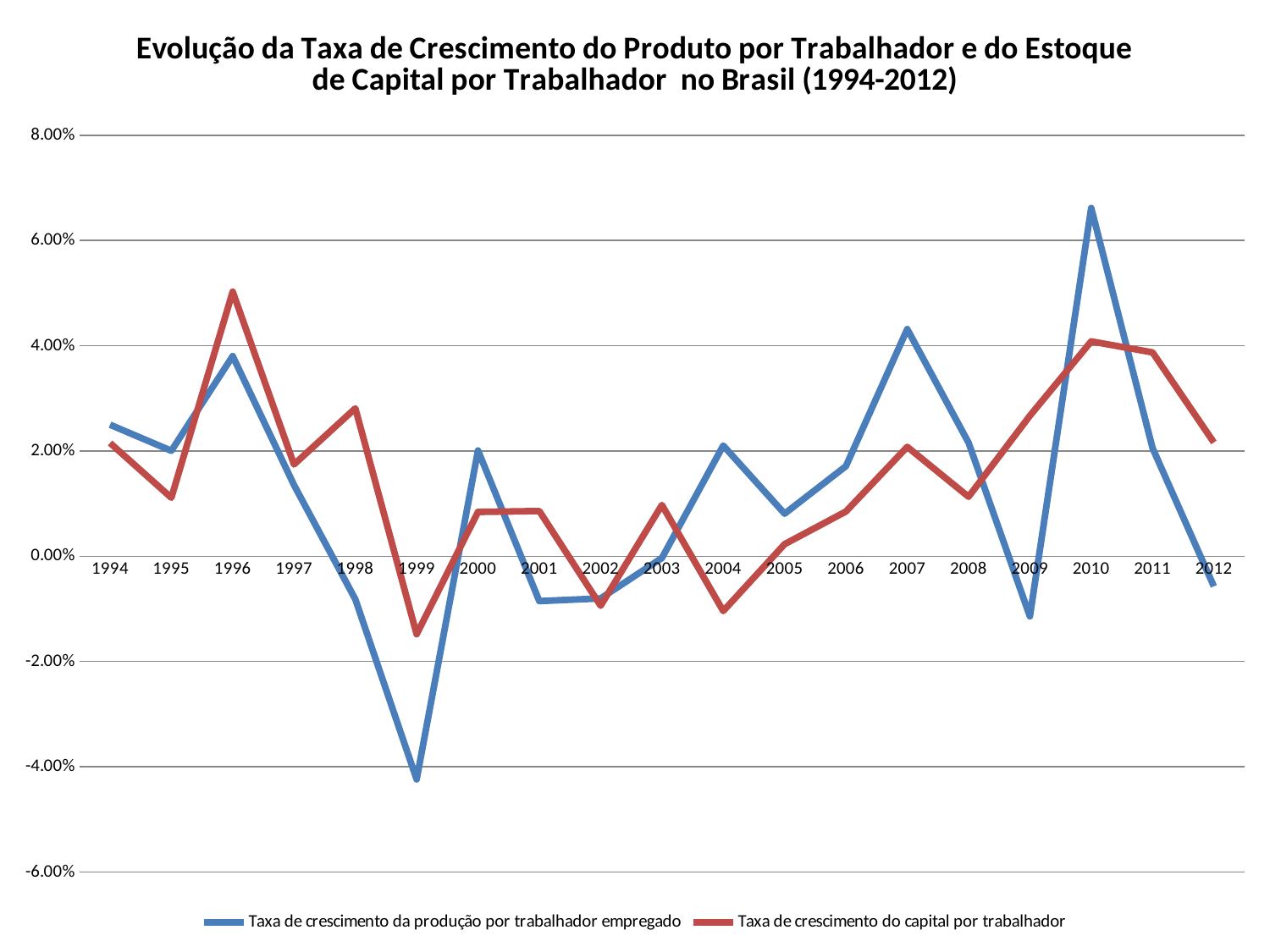
In which year does the 'Taxa de crescimento do capital por trabalhador' series reach its lowest value? 1999 How many series does the legend list? 2 In which year does the 'Taxa de crescimento da produção por trabalhador empregado' series reach its highest value? 2010 Is the value for 'Taxa de crescimento da produção por trabalhador empregado' in 1999 greater or less than -4.00%? less How many years are plotted along the x axis? 19 In which year does the 'Taxa de crescimento da produção por trabalhador empregado' series reach its lowest value? 1999 Is the value for 'Taxa de crescimento do capital por trabalhador' in 1996 greater or less than 4.00%? greater What kind of chart is shown on the slide? line chart Is the value for 'Taxa de crescimento da produção por trabalhador empregado' in 2010 greater or less than 6.00%? greater In which year does the 'Taxa de crescimento do capital por trabalhador' series reach its highest value? 1996 In 1996, which series has the higher value: 'Taxa de crescimento da produção por trabalhador empregado' or 'Taxa de crescimento do capital por trabalhador'? Taxa de crescimento do capital por trabalhador Does the 'Taxa de crescimento da produção por trabalhador empregado' series rise or fall from 2010 to 2012? fall